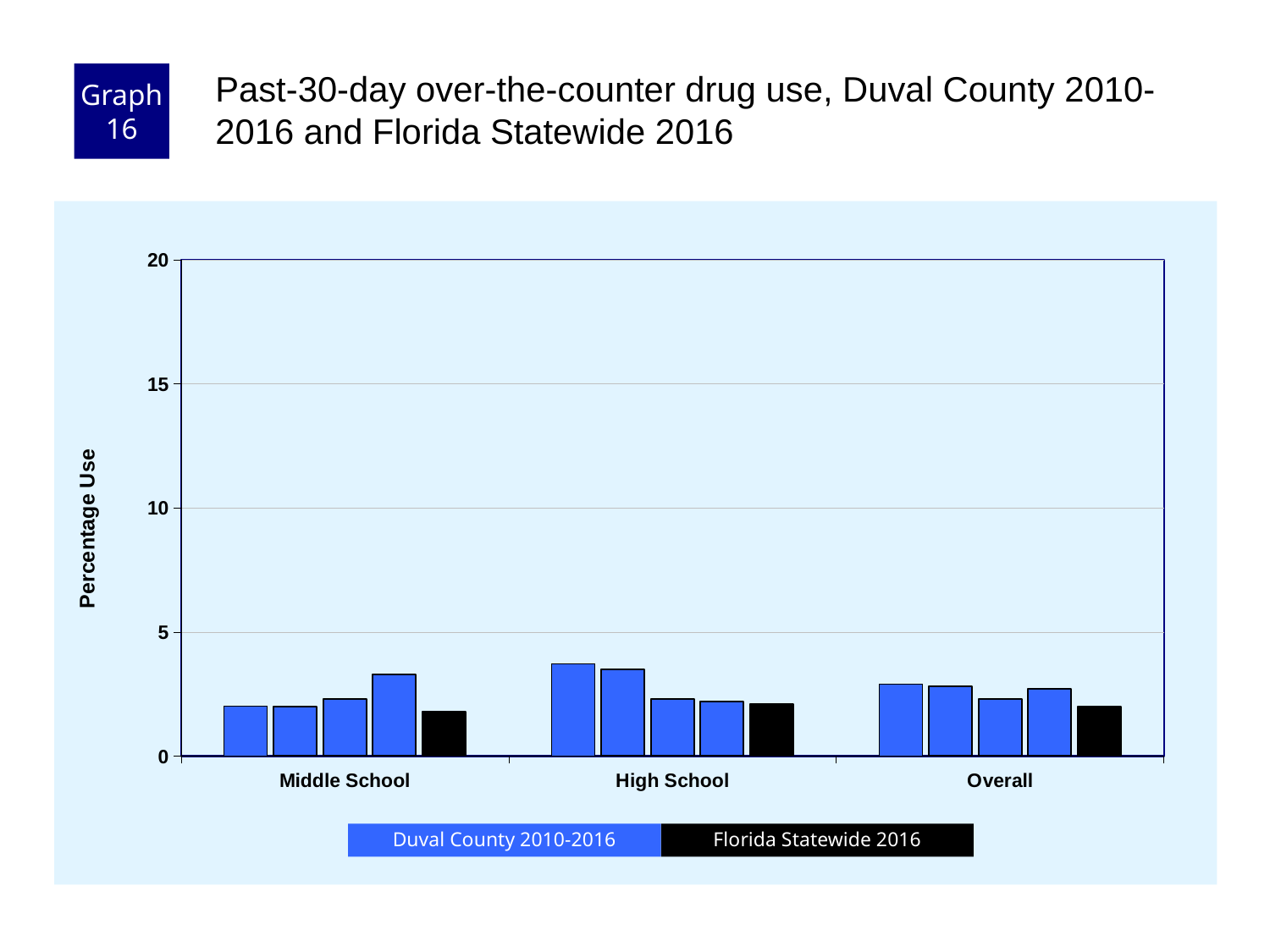
Do the Duval County 2010-2016 bars in the Middle School group rise or fall from left to right? rise In the High School group, which is larger: the first Duval County bar or the Florida Statewide 2016 bar? the first Duval County bar What is the label on the y axis? Percentage Use How many series does the legend list? 2 Which colour represents Florida Statewide 2016 in the legend? black In the Middle School group, which is larger: the last Duval County bar or the Florida Statewide 2016 bar? the last Duval County bar Is the Florida Statewide 2016 value for High School greater or less than 5? less Is the highest bar in the Middle School group greater or less than 5? less Do the Duval County 2010-2016 bars in the High School group rise or fall from left to right? fall Are any of the bars on the chart greater than 10? no What kind of chart is shown on the slide? bar chart How many categories are shown along the x axis? 3